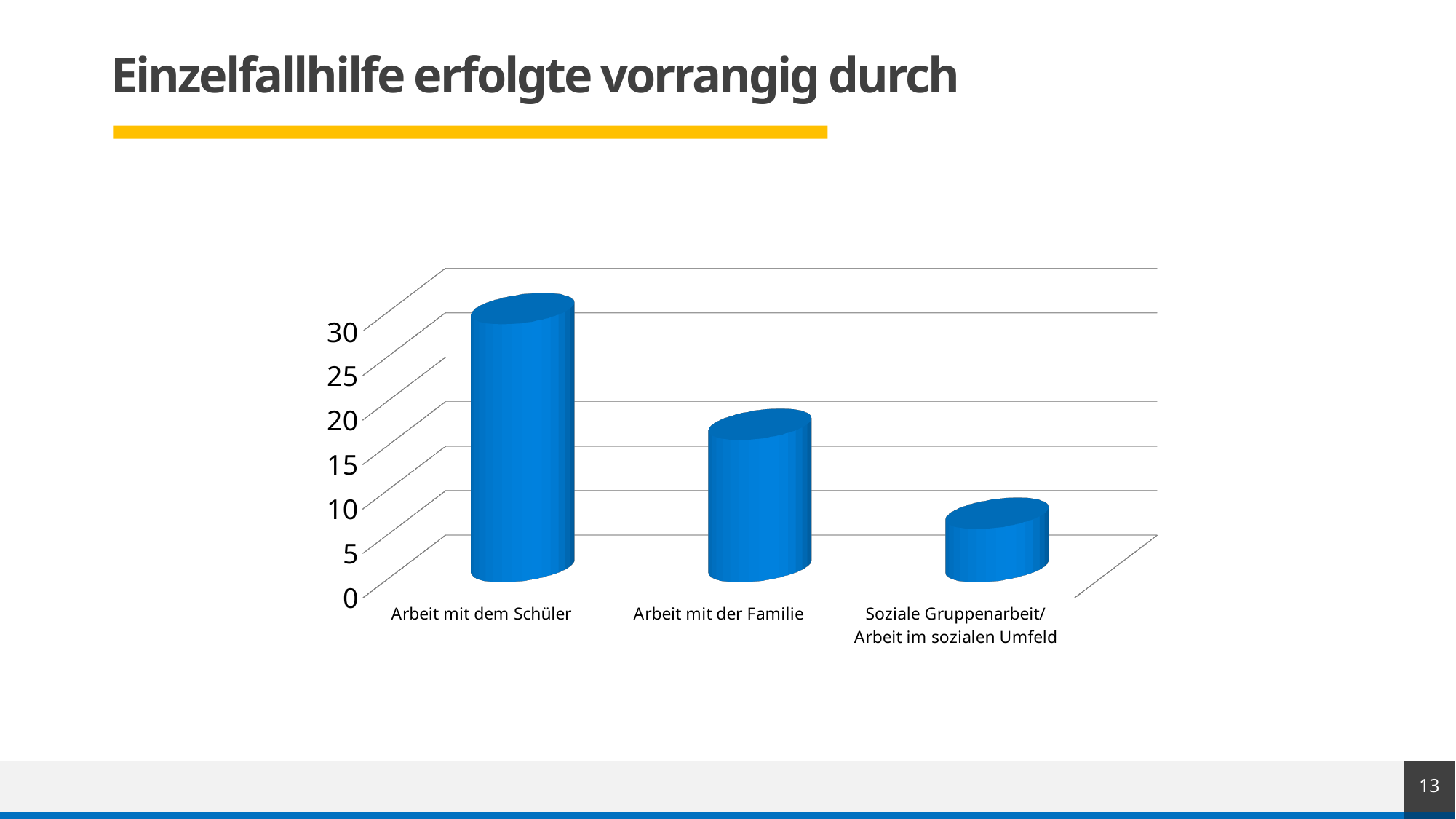
How many categories are shown on the x axis of the chart? 3 Is the value for Arbeit mit der Familie greater or less than 10? greater Which category has the highest value in the chart? Arbeit mit dem Schüler What is the title of the slide containing the chart? Einzelfallhilfe erfolgte vorrangig durch Is the value for Arbeit mit der Familie greater or less than 25? less Which is larger: the value for Arbeit mit dem Schüler or the value for Arbeit mit der Familie? Arbeit mit dem Schüler Which category has the lowest value in the chart? Soziale Gruppenarbeit/ Arbeit im sozialen Umfeld Is the value for Arbeit mit dem Schüler greater or less than 25? greater Which is larger: the value for Arbeit mit der Familie or the value for Soziale Gruppenarbeit/ Arbeit im sozialen Umfeld? Arbeit mit der Familie Do the values rise or fall from left to right along the x axis? fall What kind of chart is shown on the slide? bar chart